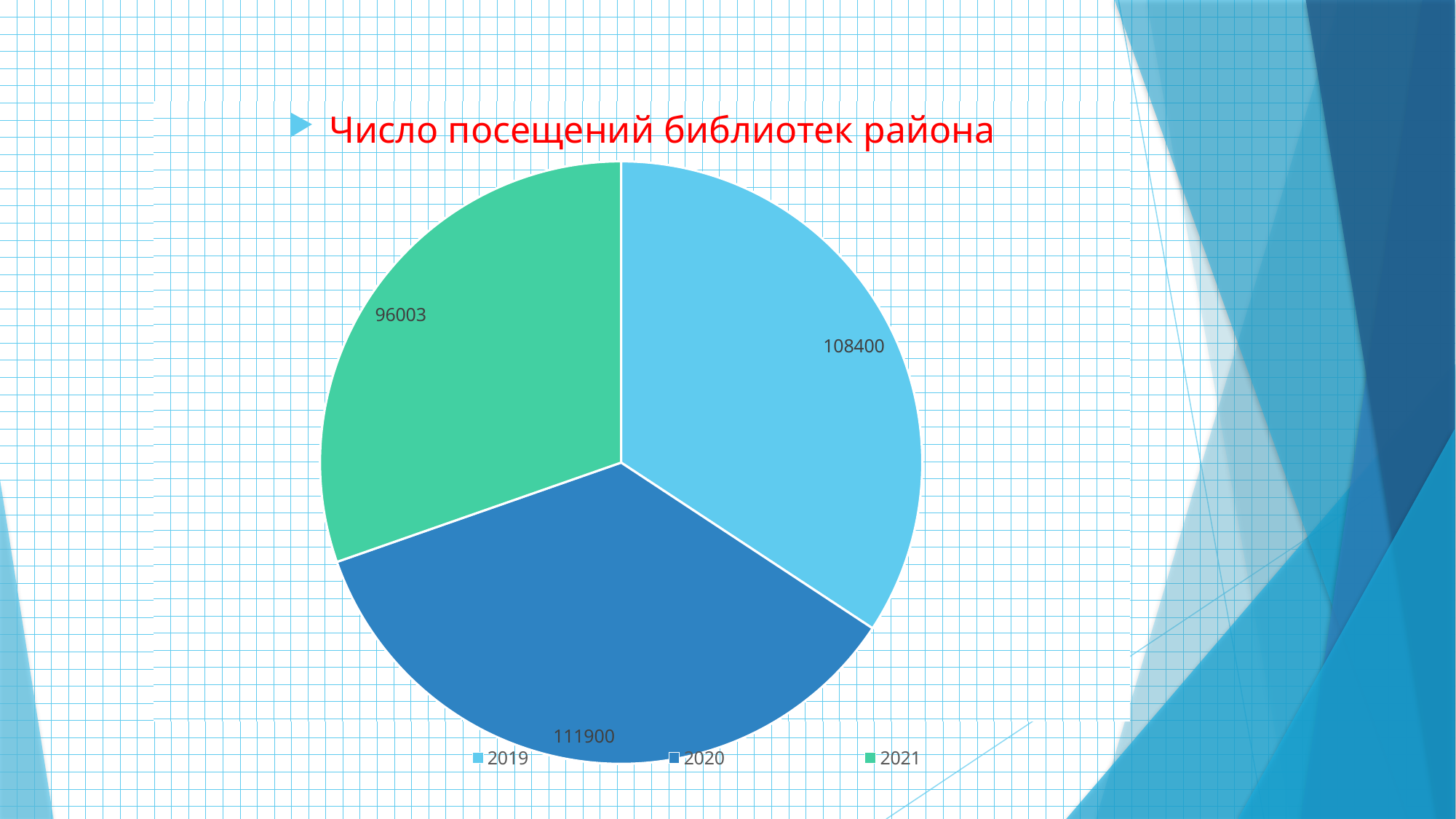
What is the value for 2020? 111900 Which year has the lowest value? 2021 What is the title of the chart? Число посещений библиотек района What is the value for 2021? 96003 What is the difference between the values for 2019 and 2021? 12397 Which year has the highest value? 2020 Which is larger, the value for 2019 or the value for 2021? 2019 What type of chart is shown on the slide? pie chart How many slices does the pie chart have? 3 What is the value for 2019? 108400 What is the difference between the values for 2020 and 2019? 3500 How many entries does the legend list? 3